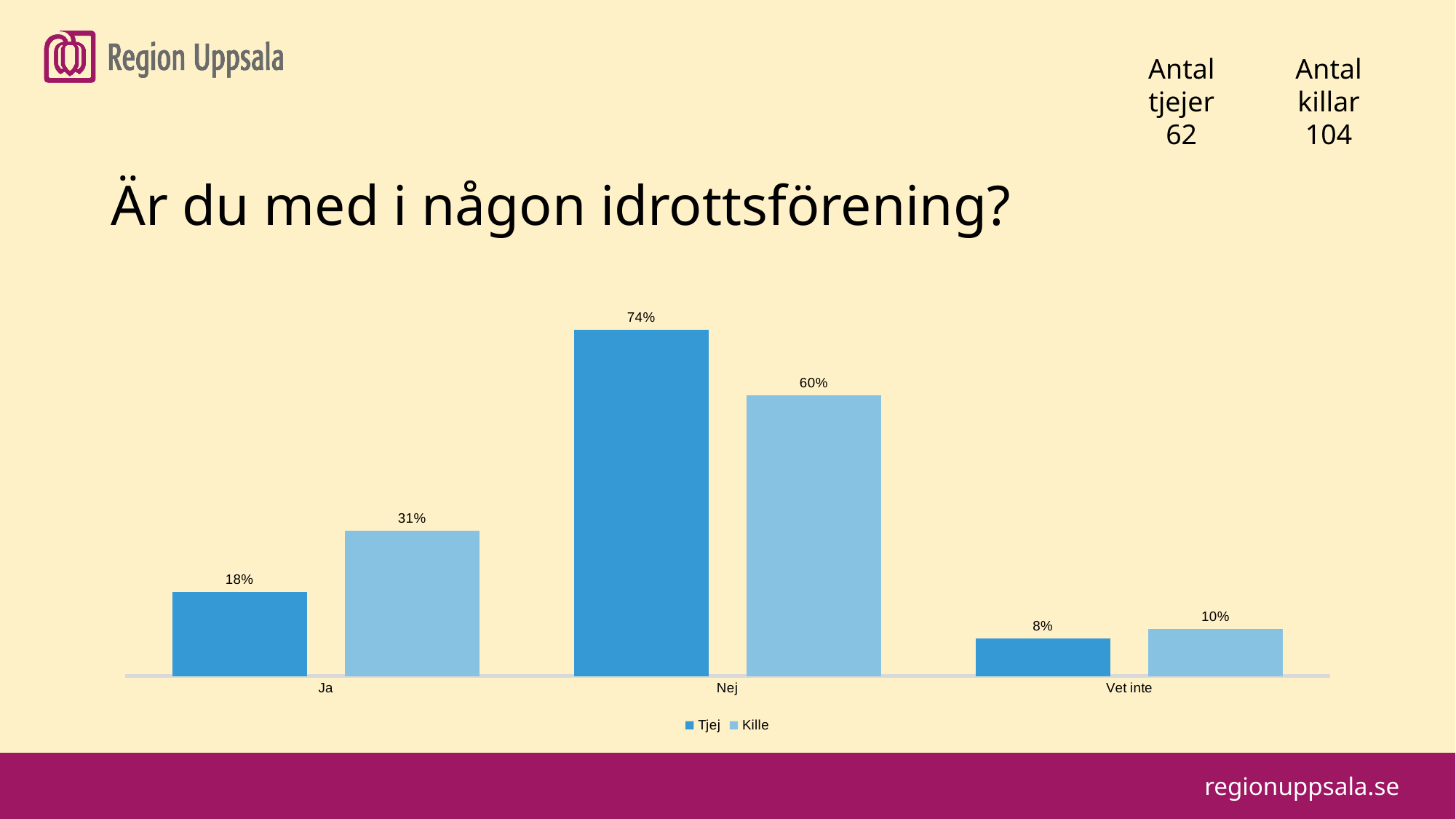
Which category has the lowest value for Kille? Vet inte Which is larger in the Vet inte category, Tjej or Kille? Kille How many series does the legend list? 2 What is the value for Tjej in the Ja category? 18% How many categories are shown on the x axis? 3 What kind of chart is shown on the slide? Bar chart What is the value for Tjej in the Vet inte category? 8% Which category has the highest value for Tjej? Nej What is the value for Kille in the Nej category? 60% What is the difference between the Tjej and Kille values in the Nej category? 14% What is the value for Kille in the Ja category? 31% What is the difference between the Kille and Tjej values in the Ja category? 13%